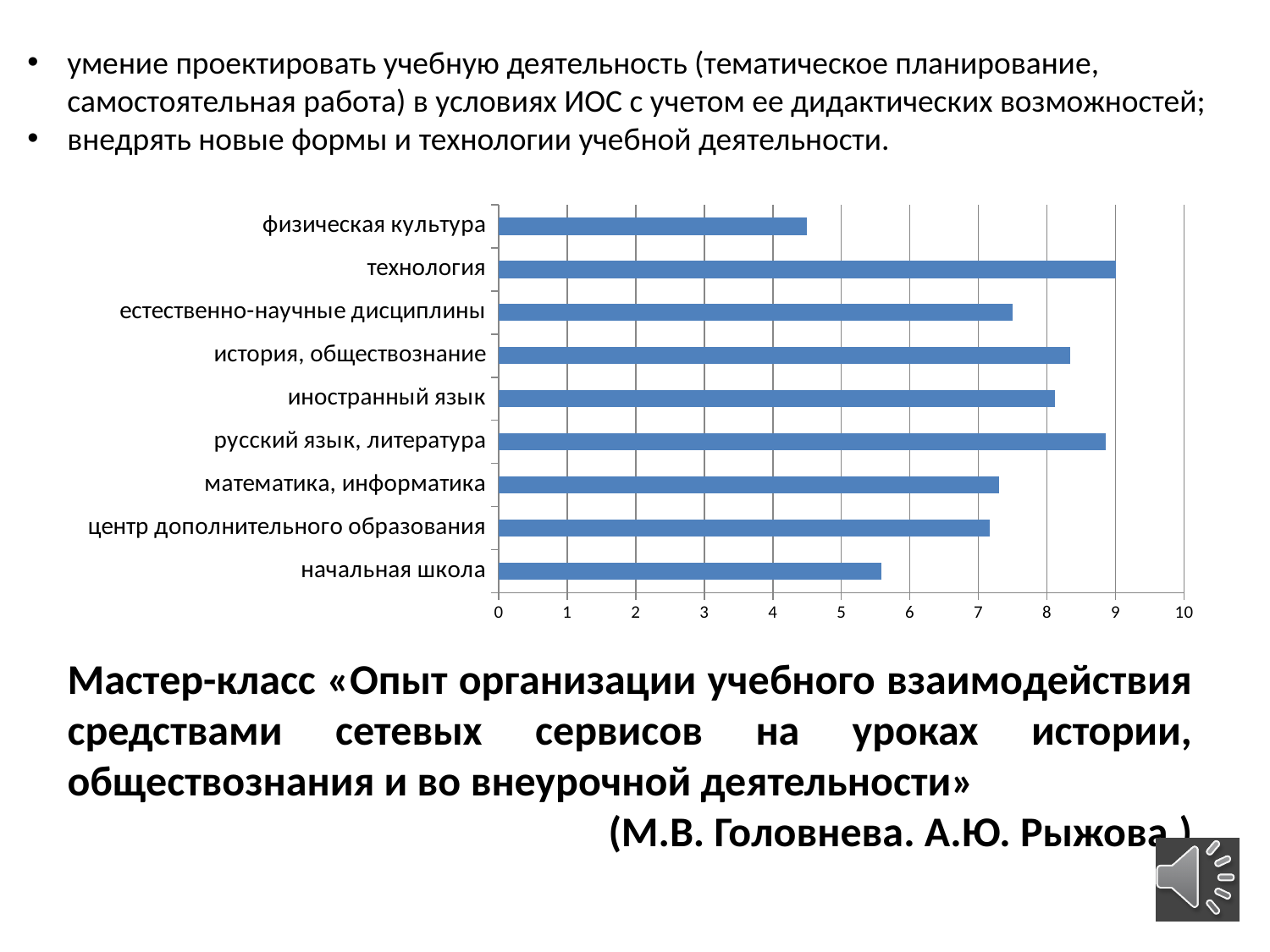
Is the value for начальная школа greater or less than 5? greater Which has a larger value, технология or физическая культура? технология Is the value for естественно-научные дисциплины greater or less than 8? less Which has a larger value, начальная школа or математика, информатика? математика, информатика How many categories are shown in the bar chart? 9 Which category has the lowest value in the bar chart? физическая культура What kind of chart is shown on the slide? bar chart Which category has the highest value in the bar chart? технология Is the value for физическая культура greater or less than 5? less What is the value for технология? 9